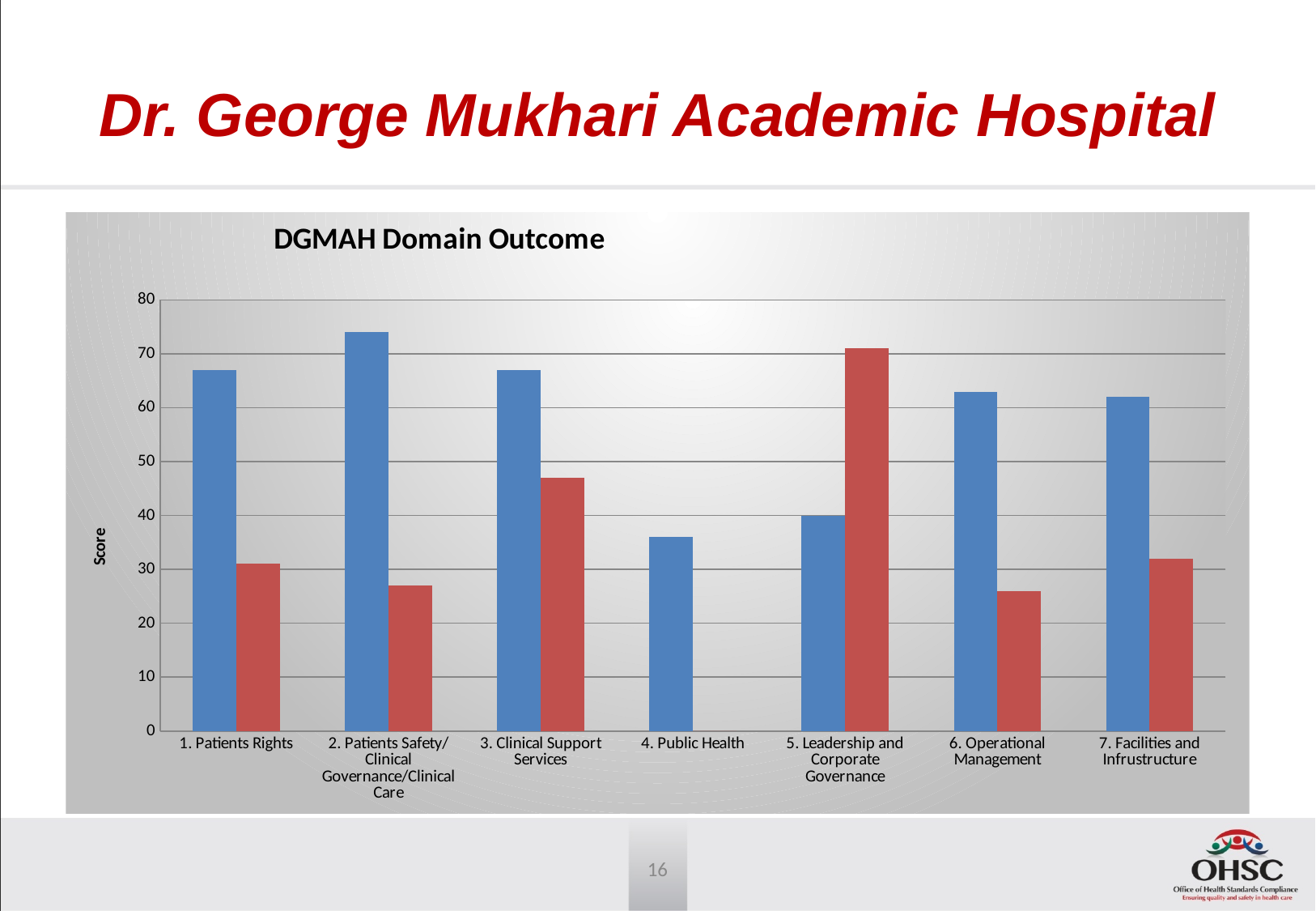
Is the red bar for 3. Clinical Support Services greater or less than 50? less Which category has the shortest blue bar? 4. Public Health Which category has the tallest red bar? 5. Leadership and Corporate Governance Is the red bar for 5. Leadership and Corporate Governance greater or less than 60? greater Which category has only a blue bar and no red bar? 4. Public Health Is the blue bar for 4. Public Health greater or less than 40? less For 5. Leadership and Corporate Governance, which bar is taller, the blue or the red? red How many domain categories are shown on the x axis? 7 Which category has the tallest blue bar? 2. Patients Safety/Clinical Governance/Clinical Care What kind of chart is shown on the slide? bar chart What is the title of the chart? DGMAH Domain Outcome